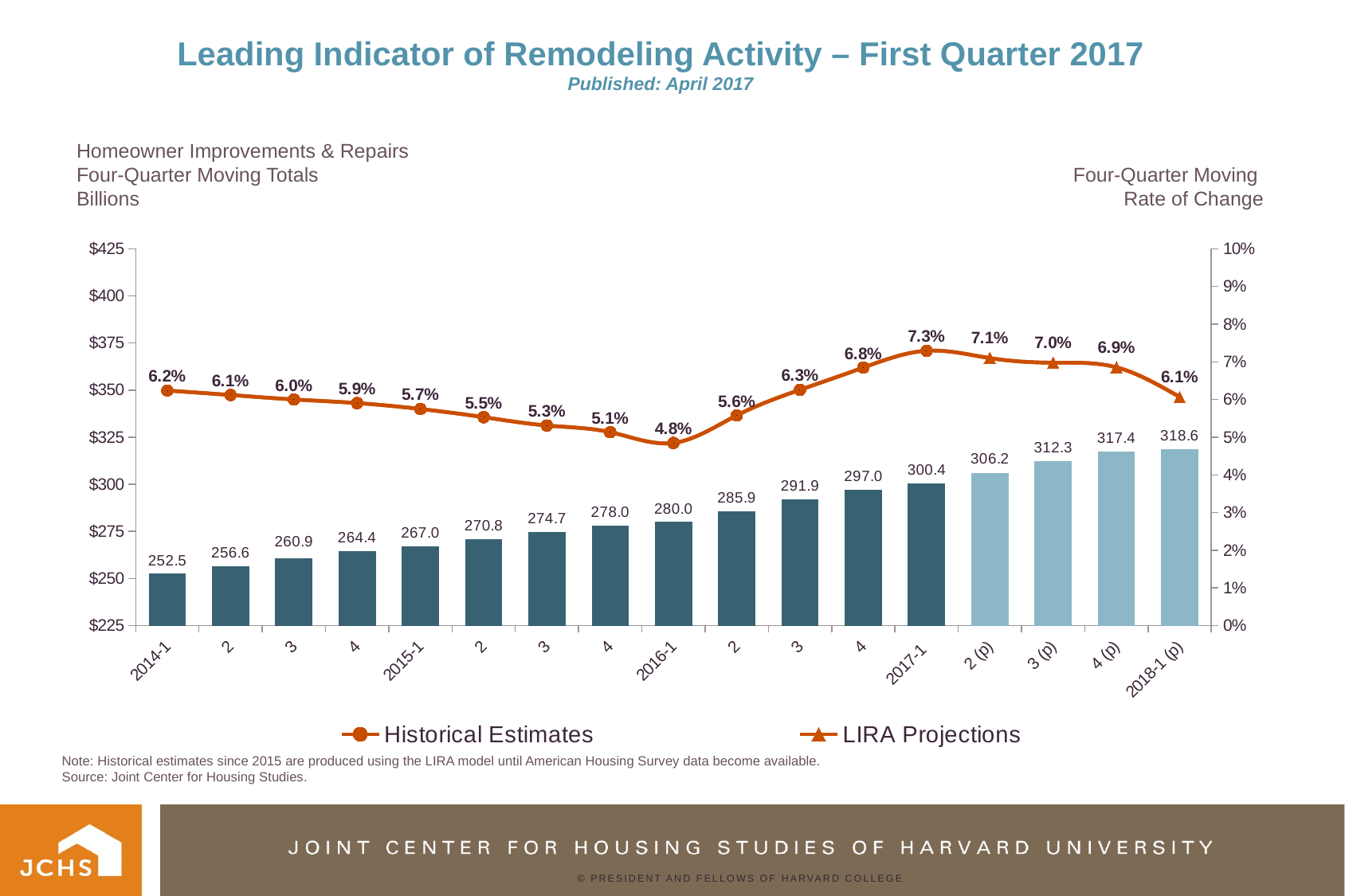
How many series does the legend list? 2 What is the four-quarter moving total shown for the projected quarter 2 (p) of 2017? 306.2 Which quarter has the lowest four-quarter moving rate of change? 2016-1 What kind of chart is shown on the slide? Combination bar and line chart Do the four-quarter moving totals (bars) rise or fall from 2014-1 to 2018-1 (p)? Rise What are the two series named in the legend? Historical Estimates and LIRA Projections What is the difference between the four-quarter moving total for 2018-1 (p) and for 2014-1? 66.1 Which quarter has the highest four-quarter moving rate of change? 2017-1 How many quarters are shown along the x axis? 17 Which has the higher rate of change, 2015-1 or 2016-1? 2015-1 What is the four-quarter moving rate of change shown for 2017-1? 7.3% What is the four-quarter moving total (in billions) shown for 2016-1? 280.0